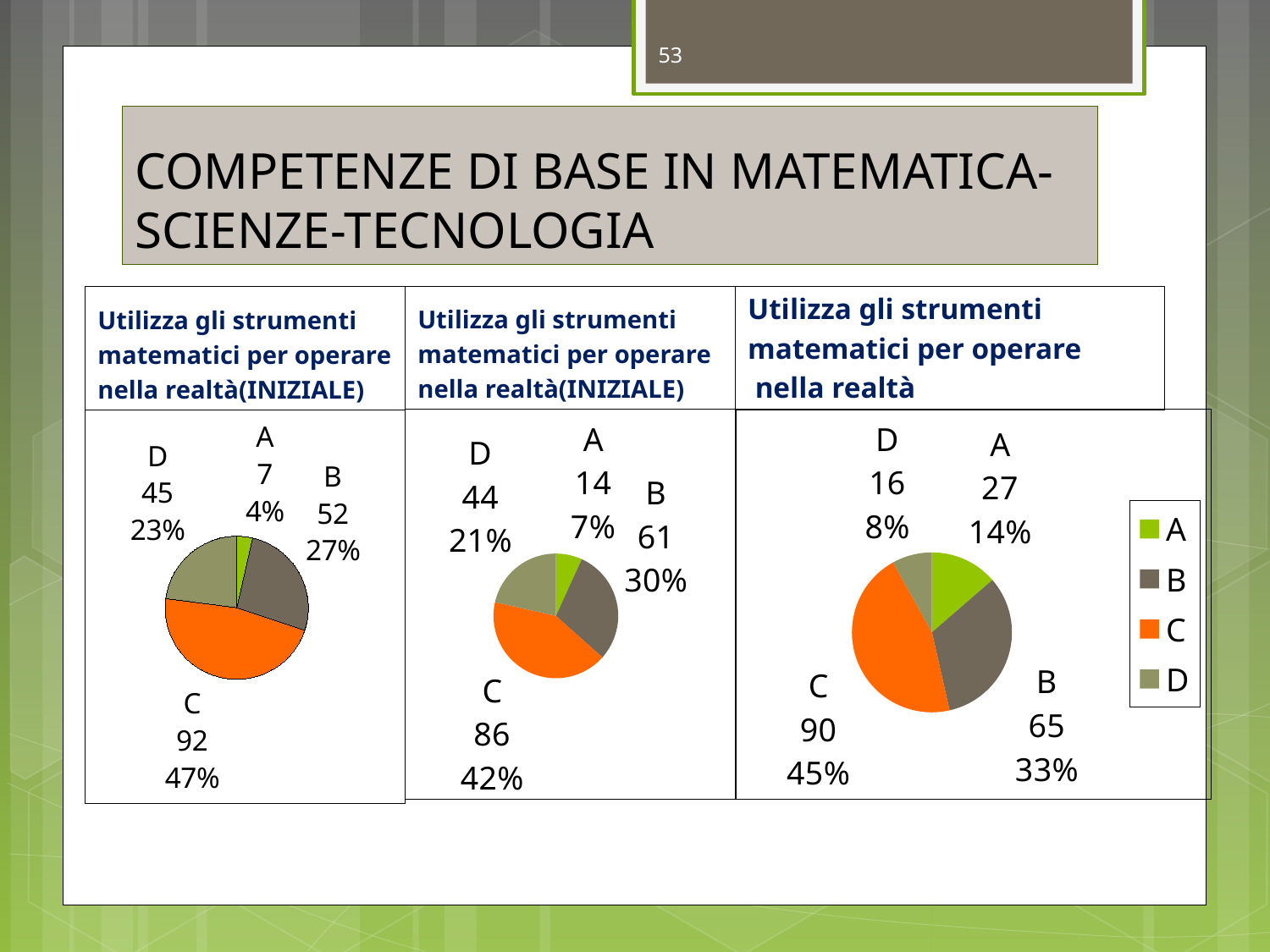
How many categories does the legend on the right of the slide list? 4 In the middle pie chart, what value is shown for category B? 61 In the left pie chart, what percentage share does category A have? 4% In the right pie chart (Utilizza gli strumenti matematici per operare nella realtà), which category has the smallest slice? D In the left pie chart, which category has the smallest slice? A What type of chart is used in the right chart (Utilizza gli strumenti matematici per operare nella realtà)? Pie chart In the right pie chart (Utilizza gli strumenti matematici per operare nella realtà), which is larger, the value for B or the value for C? C In the middle pie chart, what is the difference between the values for C and B? 25 In the middle pie chart, what percentage share does category D have? 21% In the right pie chart (Utilizza gli strumenti matematici per operare nella realtà), what value is shown for category A? 27 In the left pie chart, what value is shown for category C? 92 In the left pie chart, which category has the largest slice? C